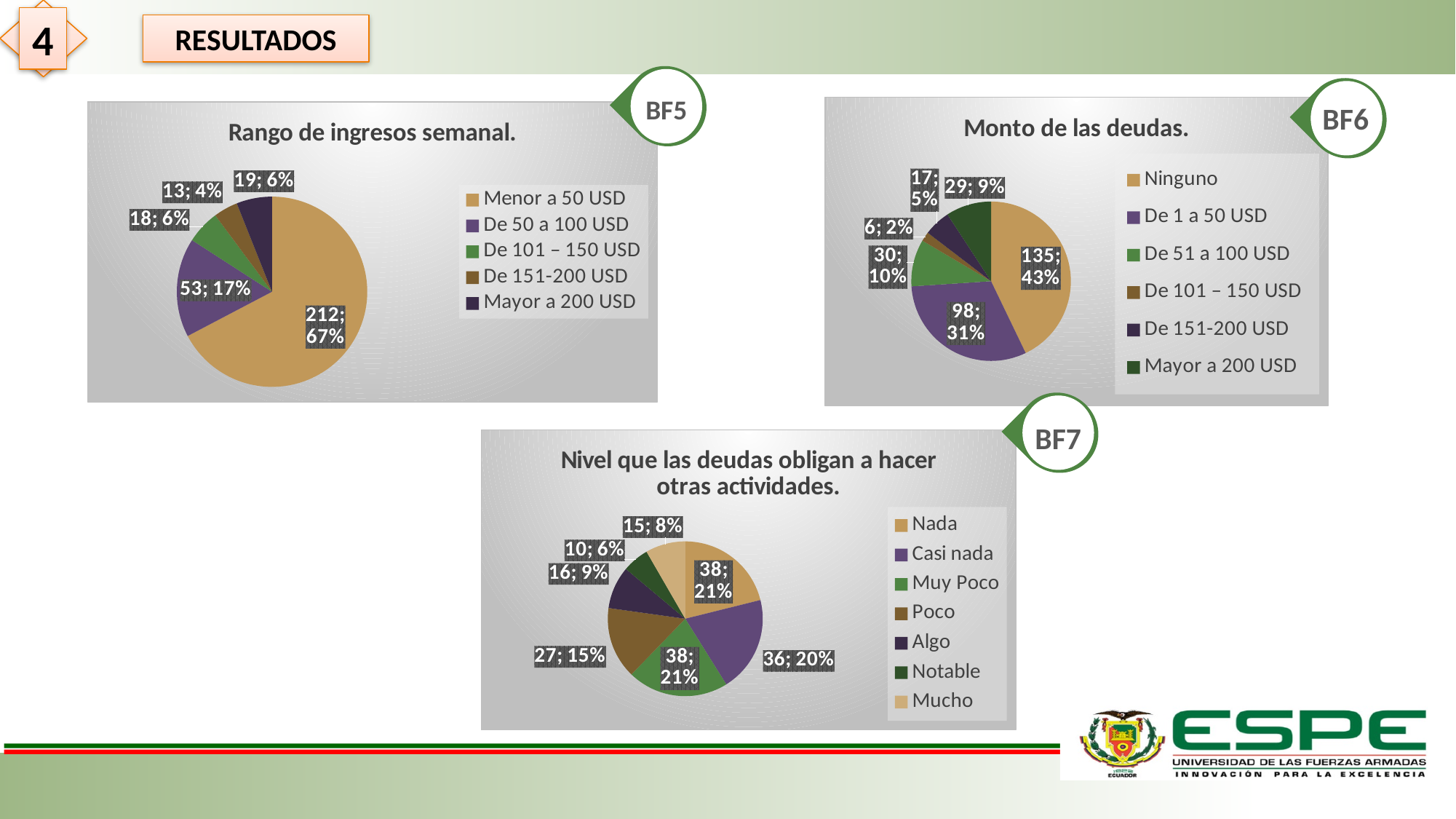
In the chart titled "Rango de ingresos semanal.", which category has the smallest slice? De 151-200 USD In the chart titled "Monto de las deudas.", which category has the largest slice? Ninguno What kind of chart is "Nivel que las deudas obligan a hacer otras actividades."? Pie chart In the chart titled "Monto de las deudas.", what percentage share does "De 101 – 150 USD" have? 2% In the chart titled "Rango de ingresos semanal.", how many categories does the legend list? 5 In the chart titled "Monto de las deudas.", what value is shown for "De 1 a 50 USD"? 98; 31% In the chart titled "Monto de las deudas.", which is larger, "De 151-200 USD" or "Mayor a 200 USD"? Mayor a 200 USD In the chart titled "Nivel que las deudas obligan a hacer otras actividades.", what value is shown for "Poco"? 27; 15% In the chart titled "Rango de ingresos semanal.", what value is shown for "Menor a 50 USD"? 212; 67% In the chart titled "Nivel que las deudas obligan a hacer otras actividades.", which category has the smallest slice? Notable In the chart titled "Rango de ingresos semanal.", what is the difference between the counts for "Menor a 50 USD" and "De 50 a 100 USD"? 159 In the chart titled "Nivel que las deudas obligan a hacer otras actividades.", how many categories does the legend list? 7